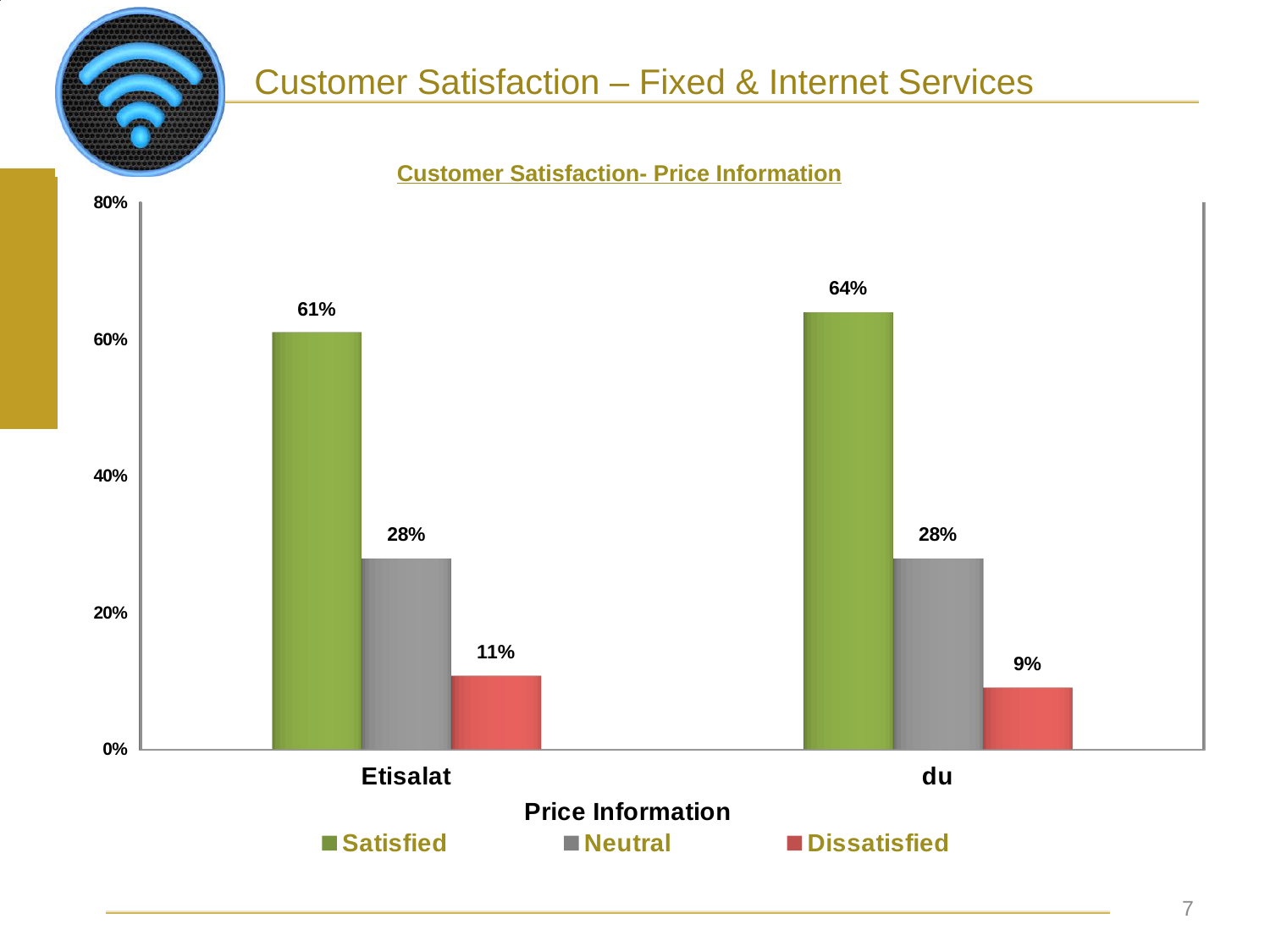
How many series does the legend list? 3 Is the Dissatisfied value for Etisalat larger or smaller than the Dissatisfied value for du? larger What kind of chart is shown? bar chart Is the Satisfied value for du greater or less than 60%? greater Which provider has the higher Satisfied value? du Which provider has the lower Dissatisfied value? du What is the difference between the Satisfied values for du and Etisalat? 3% What is the Satisfied value for Etisalat? 61% What is the difference between the Dissatisfied values for Etisalat and du? 2% How many providers are shown on the x axis? 2 What is the Dissatisfied value for du? 9% What is the Neutral value for du? 28%